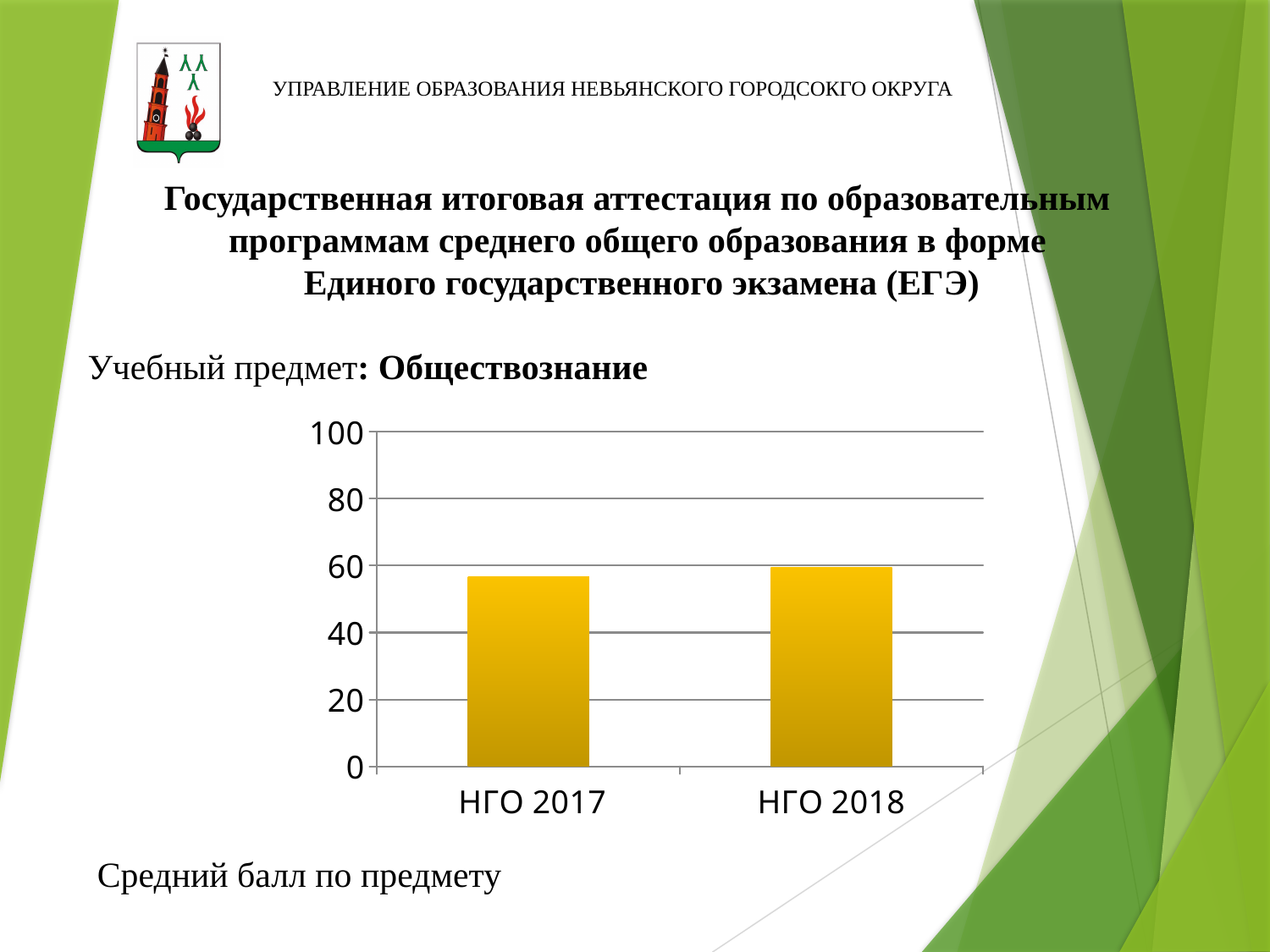
Which school subject does the chart on the slide refer to? Обществознание What kind of chart is shown on the slide? bar chart Do the values rise or fall from НГО 2017 to НГО 2018? rise Which category has the lowest value in the chart? НГО 2017 Is the value for НГО 2018 greater or less than 80? less What is the maximum value shown on the vertical axis of the chart? 100 Is the value for НГО 2017 greater or less than 60? less How many bars (categories) does the chart show? 2 Is the value for НГО 2018 greater or less than 40? greater Which category has the higher bar, НГО 2017 or НГО 2018? НГО 2018 What are the category labels on the x axis of the chart? НГО 2017, НГО 2018